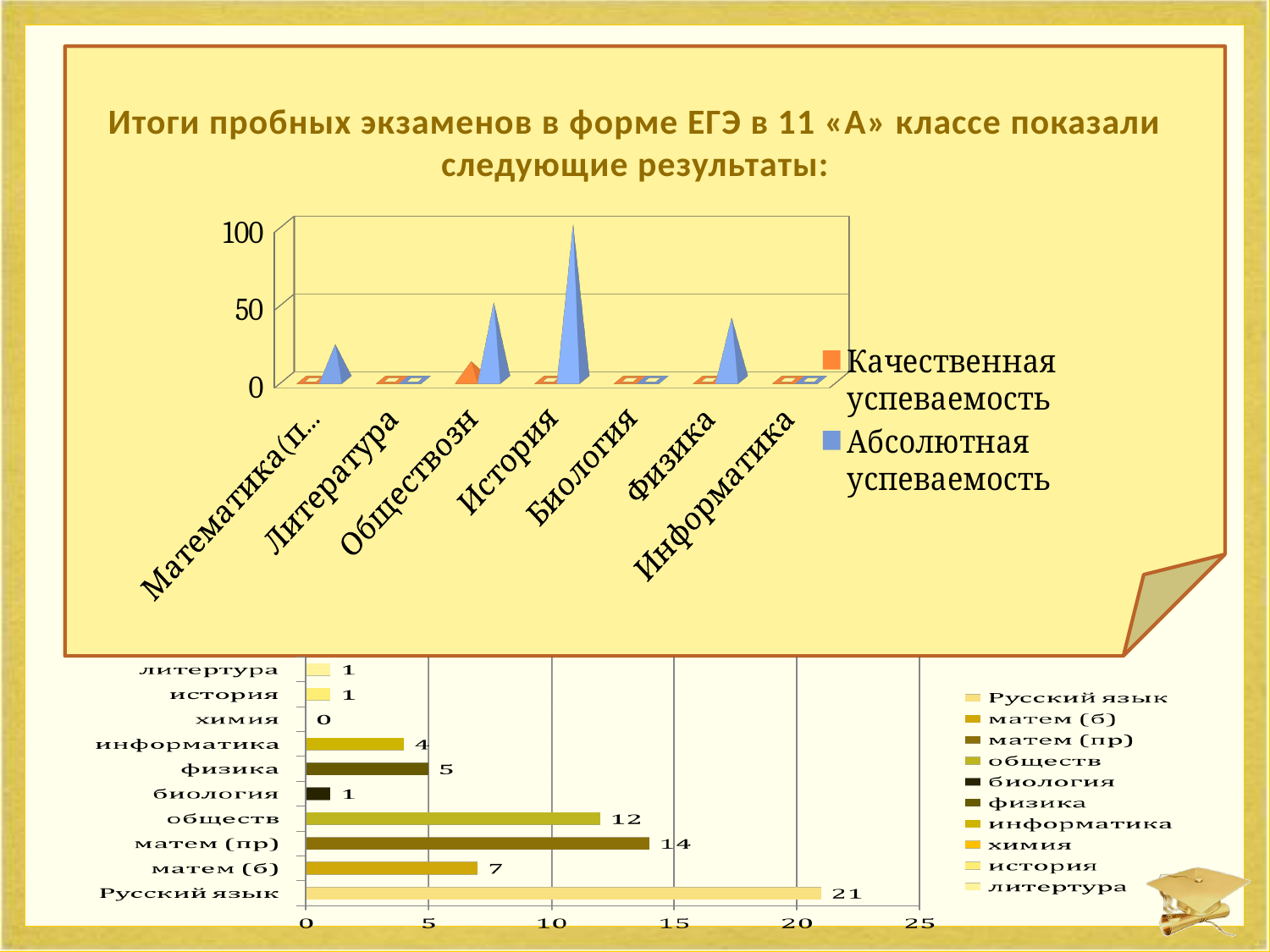
In the bottom chart, what is the value for Русский язык? 21 How many entries does the legend of the top chart list? 2 In the bottom chart, which category has the lowest value? химия In the bottom chart, what is the difference between the values for матем (пр) and матем (б)? 7 What kind of chart is the bottom chart? bar chart In the top chart, is the value of Абсолютная успеваемость for История greater or less than 50? greater In the bottom chart, which is larger: the value for обществ or the value for информатика? обществ In the bottom chart, which category has the highest value? Русский язык In the bottom chart, what is the value for физика? 5 In the top chart, is the value of Абсолютная успеваемость for Физика greater or less than 50? less How many categories are shown in the bottom chart? 10 In the bottom chart, what is the value for матем (пр)? 14